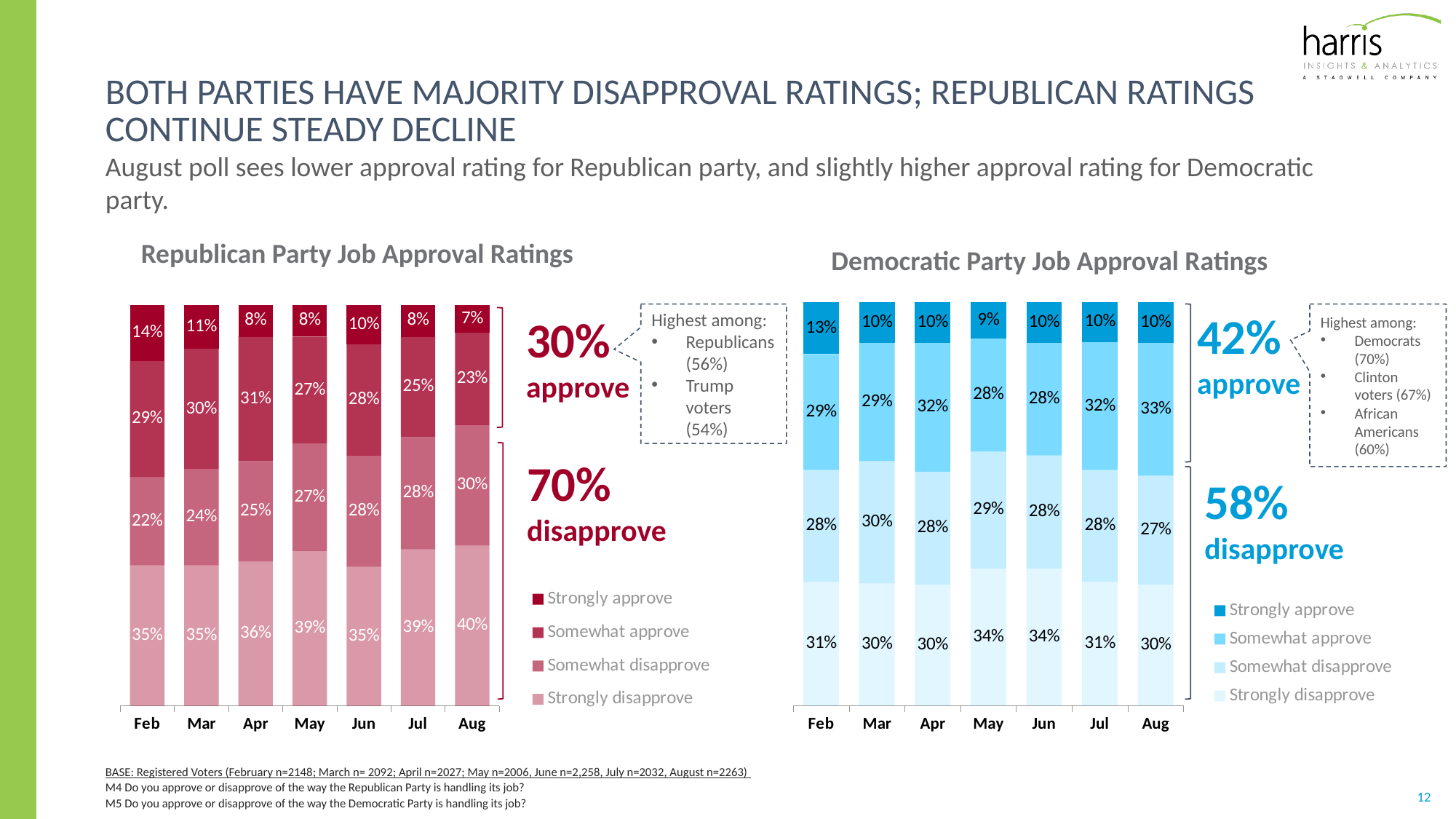
How many series does the legend of the Republican Party Job Approval Ratings chart list? 4 What kind of chart is the Democratic Party Job Approval Ratings chart? Stacked bar chart In the Republican Party Job Approval Ratings chart, which month has the highest Strongly approve value? Feb In the Democratic Party Job Approval Ratings chart, what is the Strongly disapprove value for May? 34% In the Republican Party Job Approval Ratings chart, what is the Strongly disapprove value for Aug? 40% How many months are shown on the x axis of the Democratic Party Job Approval Ratings chart? 7 In the Republican Party Job Approval Ratings chart, which month has the lowest Strongly approve value? Aug In the Republican Party Job Approval Ratings chart, what is the Strongly approve value for Feb? 14% In the Republican Party Job Approval Ratings chart, what is the difference between the Strongly disapprove values for Aug and Feb? 5% In the Republican Party Job Approval Ratings chart, does the Strongly approve value generally rise or fall from Feb to Aug? fall In the Democratic Party Job Approval Ratings chart, is the Somewhat approve value for Apr larger or smaller than the Somewhat approve value for May? larger In the Democratic Party Job Approval Ratings chart, what is the Somewhat approve value for Aug? 33%